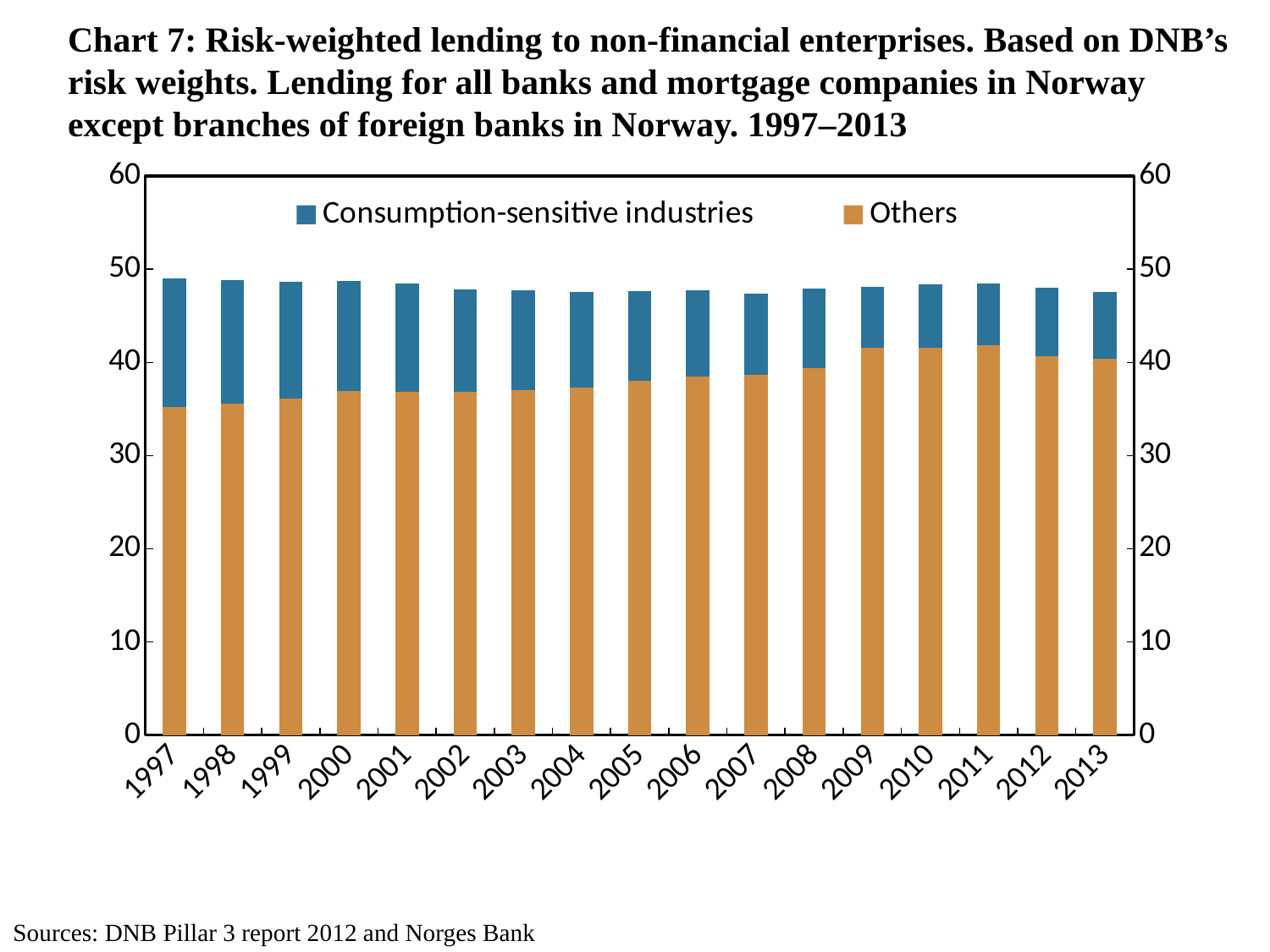
How many years are shown on the x axis? 17 Which year has the larger value for Others, 1997 or 2013? 2013 Is the value for Others in 2011 greater or less than 40? greater Which series is shown in orange? Others Is the total height of the stacked bar for 2013 greater or less than 40? greater Which two series are listed in the legend? Consumption-sensitive industries and Others What kind of chart is shown on the slide? Stacked bar chart Does the Others series generally rise or fall from 1997 to 2011? rise How many series does the legend list? 2 Is the value for Others in 1997 greater or less than 40? less